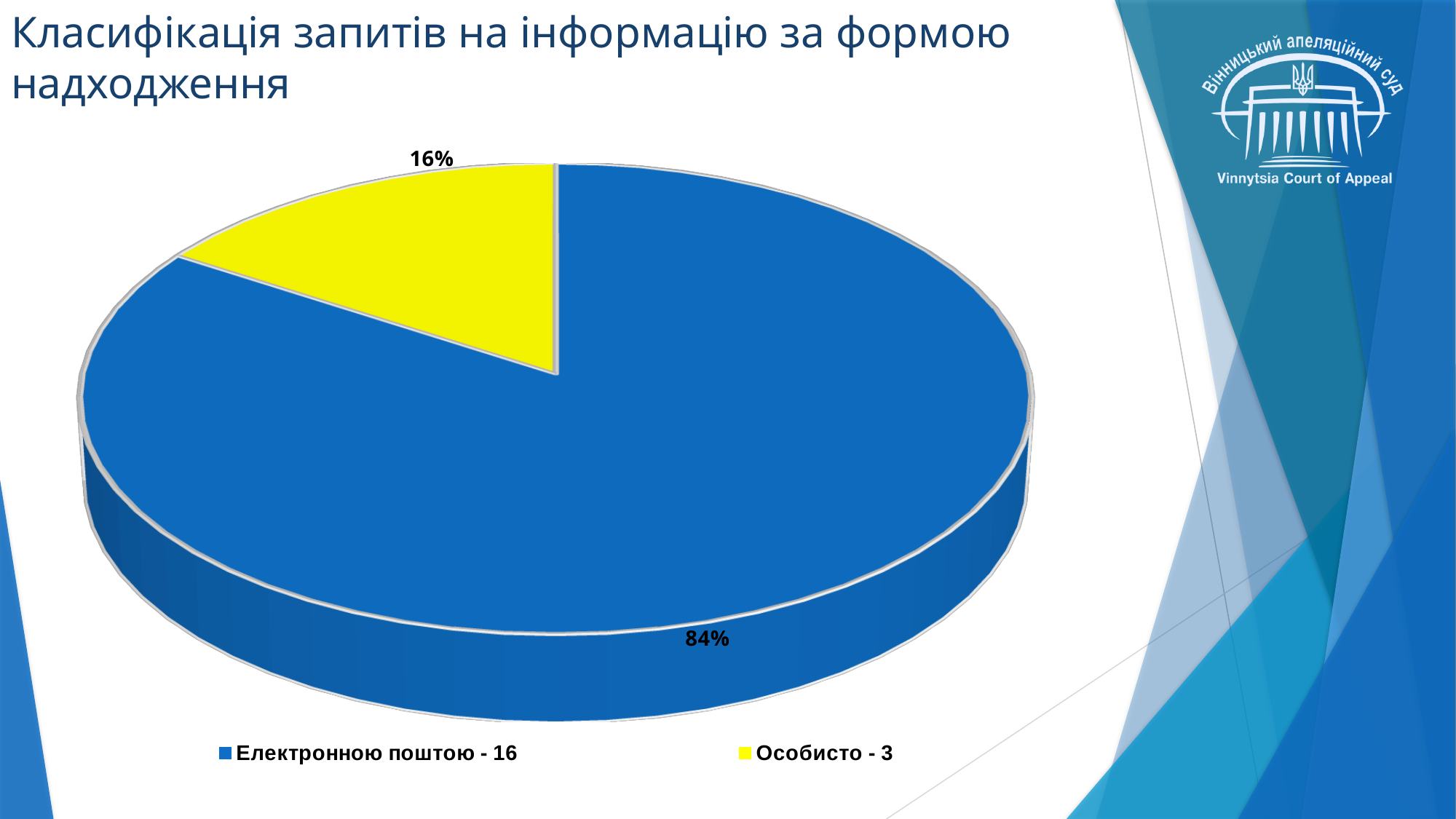
How many requests does the legend give for "Електронною поштою"? 16 What colour is the "Особисто - 3" slice? yellow What percentage share does the slice "Особисто - 3" have? 16% Which category has the largest slice of the pie? Електронною поштою - 16 What is the difference in percentage points between the "Електронною поштою" slice and the "Особисто" slice? 68 How many slices does the pie chart have? 2 Which slice is larger: "Електронною поштою" or "Особисто"? Електронною поштою Which category has the smallest slice of the pie? Особисто - 3 What percentage share does the slice "Електронною поштою - 16" have? 84% How many entries does the legend list? 2 What is the title of the slide containing the chart? Класифікація запитів на інформацію за формою надходження What kind of chart is shown on the slide? pie chart